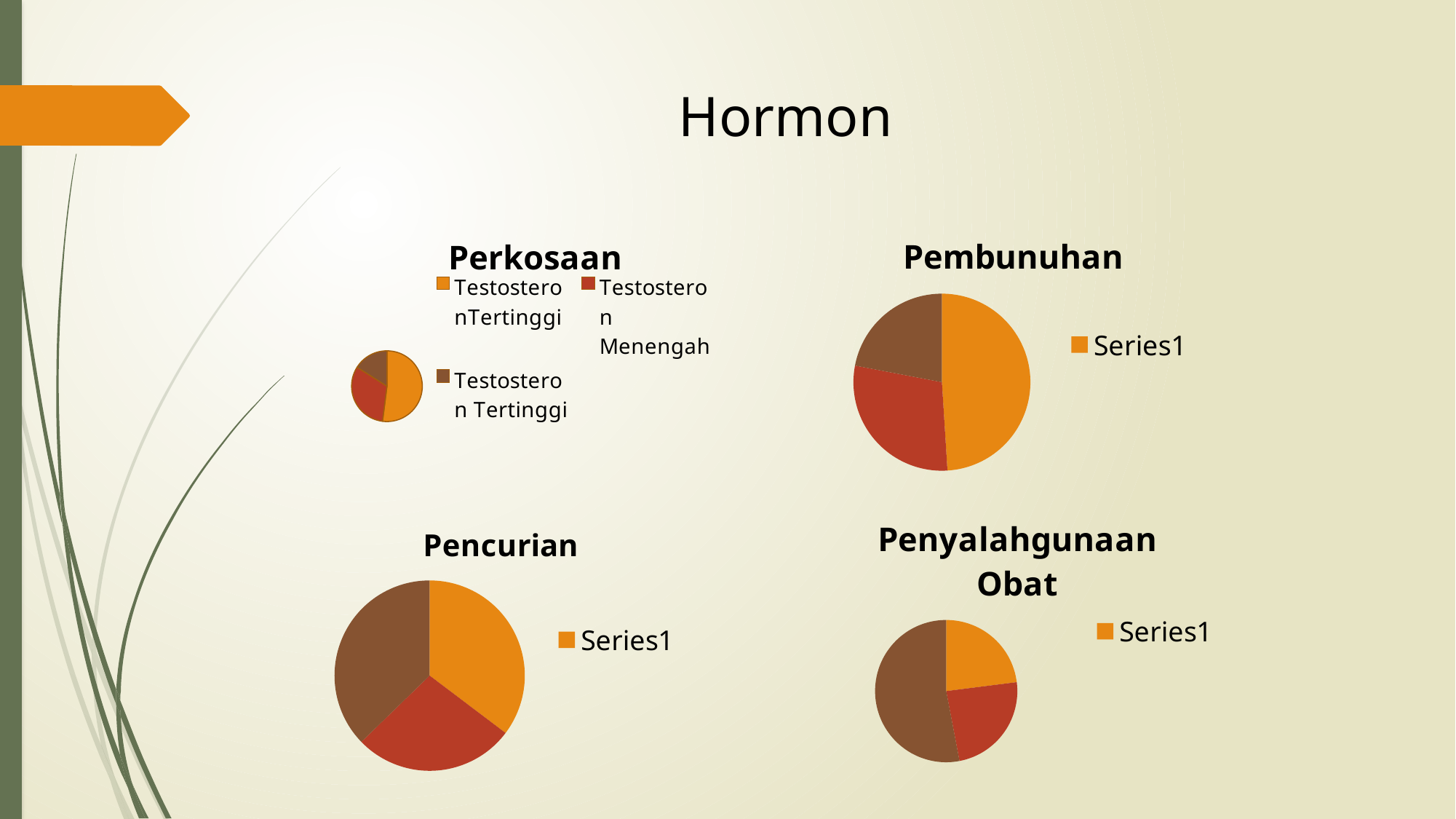
Which slice is the largest in the Penyalahgunaan Obat pie chart? the brown slice How many slices does the Pencurian pie chart have? 3 How many pie charts are shown on the slide? 4 What is the title of the pie chart in the top-left of the slide? Perkosaan Which slice is the largest in the Pembunuhan pie chart? the orange slice How many entries does the legend of the Perkosaan chart list? 3 How many entries does the legend of the Pencurian chart list? 1 What kind of chart is the Pembunuhan chart? pie chart What legend entry is shown for the Pembunuhan chart? Series1 How many slices does the Penyalahgunaan Obat pie chart have? 3 Which slice is the smallest in the Pembunuhan pie chart? the brown slice Which slice is the largest in the Pencurian pie chart? the brown slice